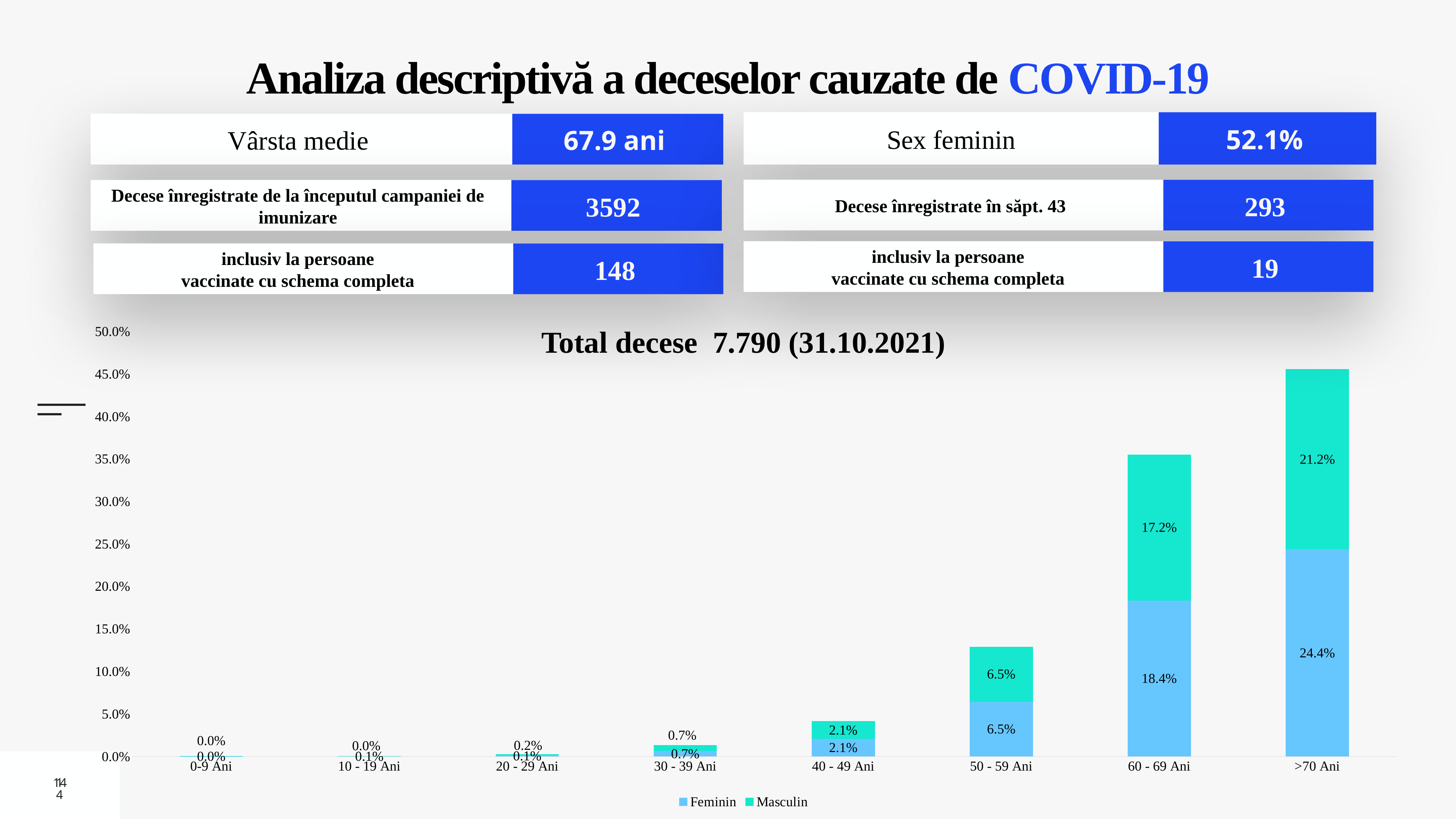
What is the Feminin value for the 50 - 59 Ani category? 6.5% Which age category has the highest Masculin value? >70 Ani What is the difference between the Feminin and Masculin values for the >70 Ani category? 3.2% Is the total stacked value for the >70 Ani bar greater or less than 40.0%? greater How many series does the chart legend list? 2 What is the Masculin value for the 60 - 69 Ani category? 17.2% What kind of chart is shown on the slide? stacked bar chart What is the Feminin value for the >70 Ani category? 24.4% What is the total of the stacked bar for the 60 - 69 Ani category? 35.6% How many age categories are shown on the x axis of the chart? 8 What is the title of the chart? Total decese 7.790 (31.10.2021) Is the Feminin value for 60 - 69 Ani larger or smaller than the Masculin value for the same category? larger